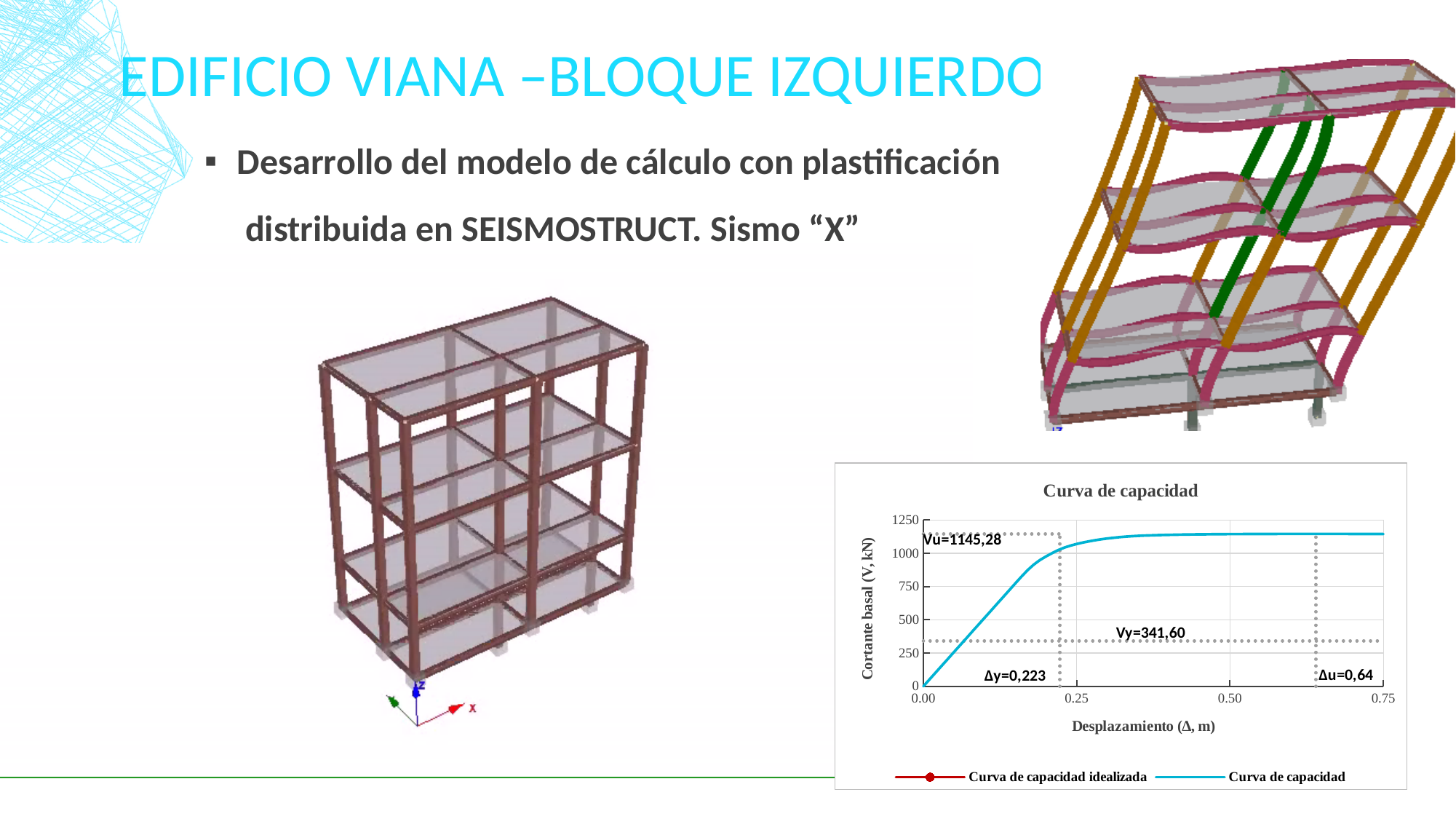
In the "Curva de capacidad" chart, what is the value of Δy? 0,223 In the "Curva de capacidad" chart, is the base shear at a displacement of 0.50 m greater or less than 1000 kN? greater In the "Curva de capacidad" chart, what is the value of Δu? 0,64 What is the label of the x axis of the "Curva de capacidad" chart? Desplazamiento (Δ, m) In the "Curva de capacidad" chart, what is the difference between Vu and Vy? 803,68 What is the title of the chart on the slide? Curva de capacidad How many series does the legend of the "Curva de capacidad" chart list? 2 In the "Curva de capacidad" chart, what is the value of Vy? 341,60 In the "Curva de capacidad" chart, which is larger, Vu or Vy? Vu In the "Curva de capacidad" chart, what is the value of Vu? 1145,28 What kind of chart is "Curva de capacidad"? line chart In the "Curva de capacidad" chart, does the base shear rise or fall as displacement increases from 0.00 to 0.25 m? rise